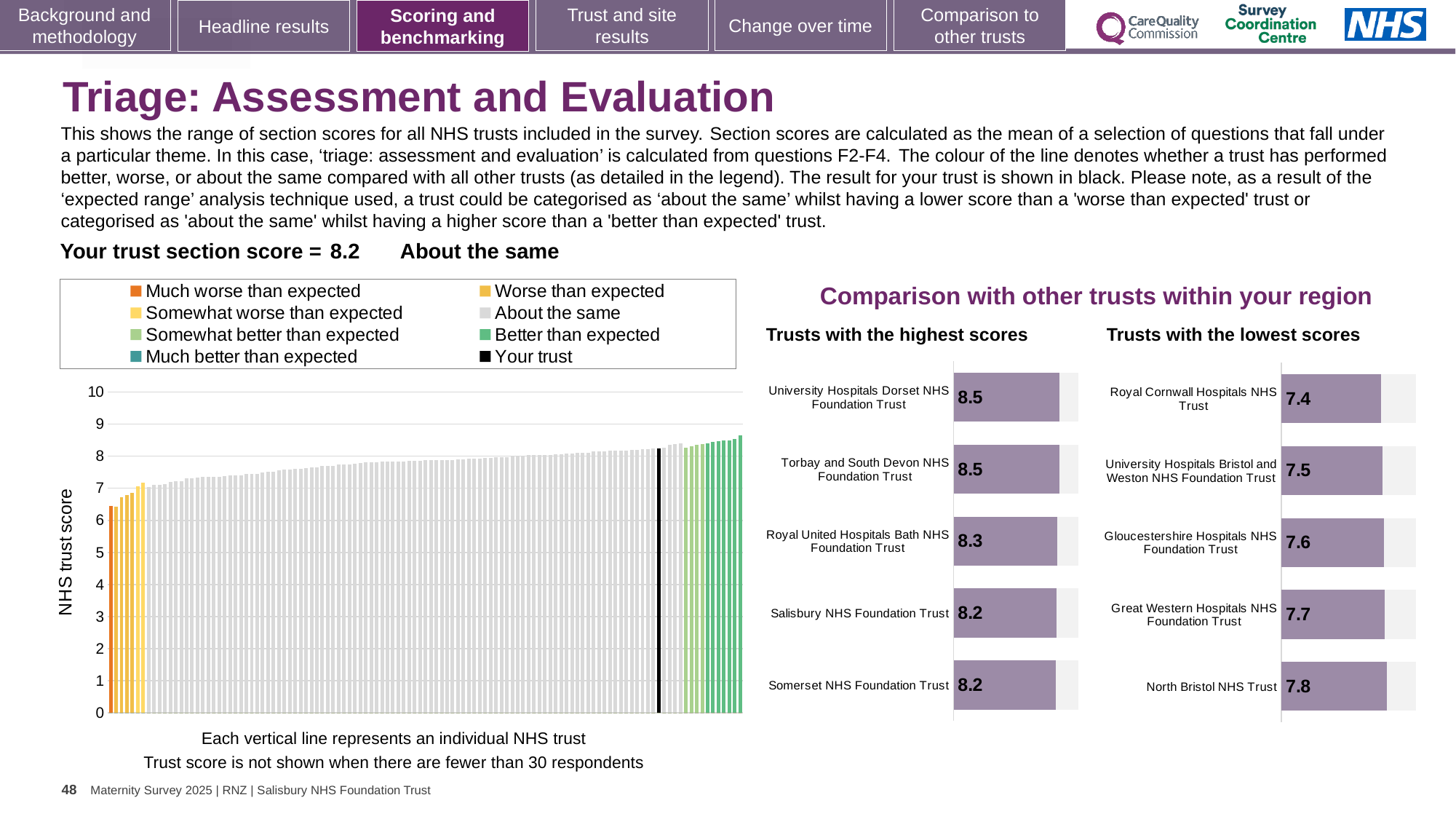
In the 'Trusts with the lowest scores' chart, what is the score for Gloucestershire Hospitals NHS Foundation Trust? 7.6 In the 'Trusts with the lowest scores' chart, which has the higher score: Great Western Hospitals NHS Foundation Trust or North Bristol NHS Trust? North Bristol NHS Trust In the large chart on the left, is the value of the leftmost (orange) bar greater or less than 7? less In the 'Trusts with the lowest scores' chart, which trust has the lowest score? Royal Cornwall Hospitals NHS Trust In the 'Trusts with the lowest scores' chart, what is the difference between the scores of North Bristol NHS Trust and Royal Cornwall Hospitals NHS Trust? 0.4 In the large chart on the left, do the NHS trust scores rise or fall from left to right? Rise In the 'Trusts with the highest scores' chart, what is the difference between the scores of University Hospitals Dorset NHS Foundation Trust and Salisbury NHS Foundation Trust? 0.3 How many entries does the legend of the large chart on the left list? 8 In the 'Trusts with the lowest scores' chart, which trust has the highest score? North Bristol NHS Trust How many trusts are listed in the 'Trusts with the highest scores' chart? 5 In the 'Trusts with the highest scores' chart, what is the score for Royal United Hospitals Bath NHS Foundation Trust? 8.3 What kind of chart is the large chart on the left showing NHS trust scores? Bar chart